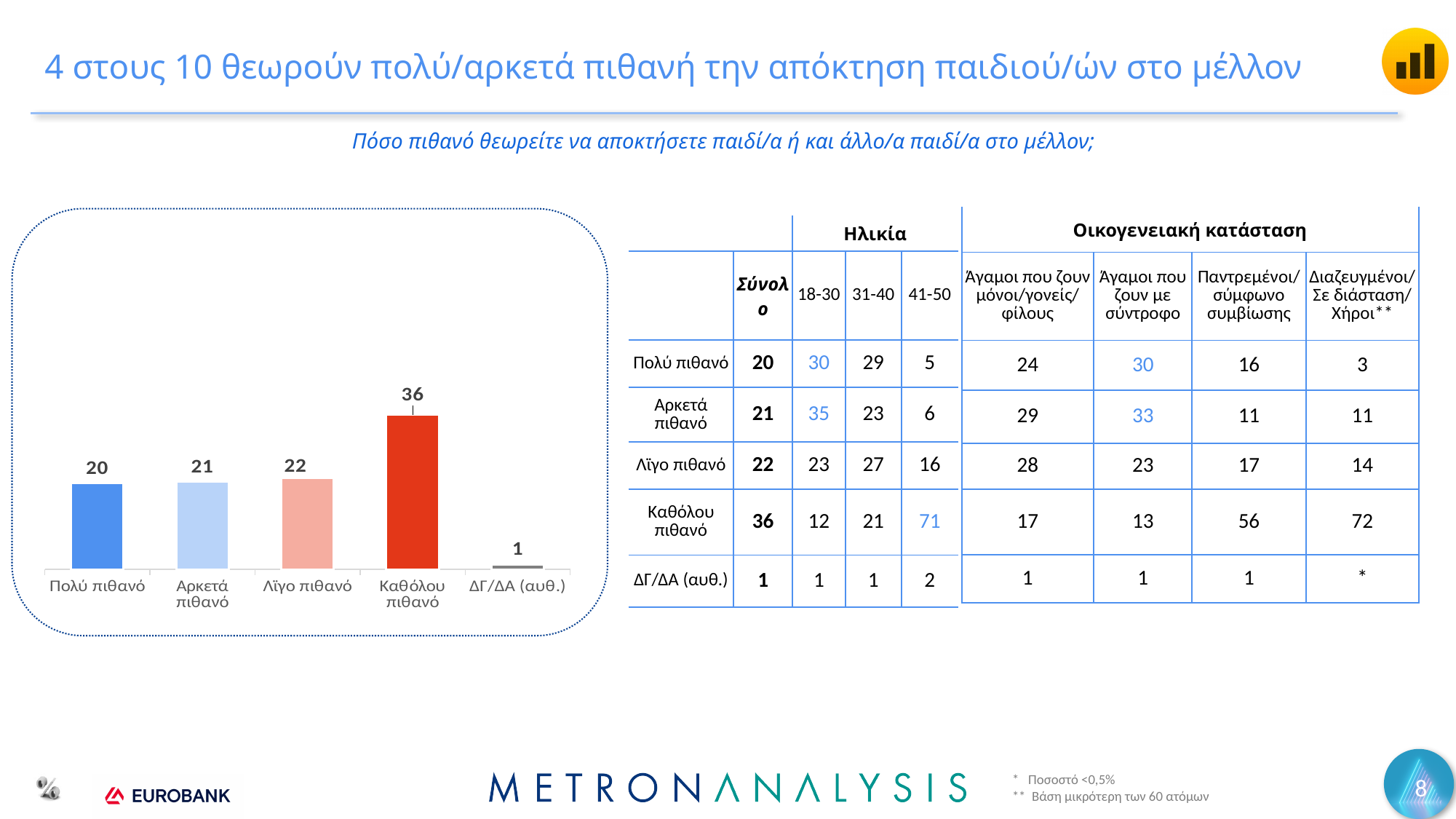
What is the value for "Αρκετά πιθανό" in the bar chart? 21 What is the value for "Λίγο πιθανό" in the bar chart? 22 What is the value for "ΔΓ/ΔΑ (αυθ.)" in the bar chart? 1 How many categories does the bar chart show? 5 Which category has the highest value in the bar chart? Καθόλου πιθανό What is the difference between the values for "Καθόλου πιθανό" and "Πολύ πιθανό" in the bar chart? 16 What is the value for "Καθόλου πιθανό" in the bar chart? 36 What colour is the bar for "Καθόλου πιθανό" in the bar chart? red Which category has the lowest value in the bar chart? ΔΓ/ΔΑ (αυθ.) Which is larger in the bar chart: the value for "Καθόλου πιθανό" or the value for "Λίγο πιθανό"? Καθόλου πιθανό What is the value for "Πολύ πιθανό" in the bar chart? 20 What type of chart is shown on the slide? bar chart